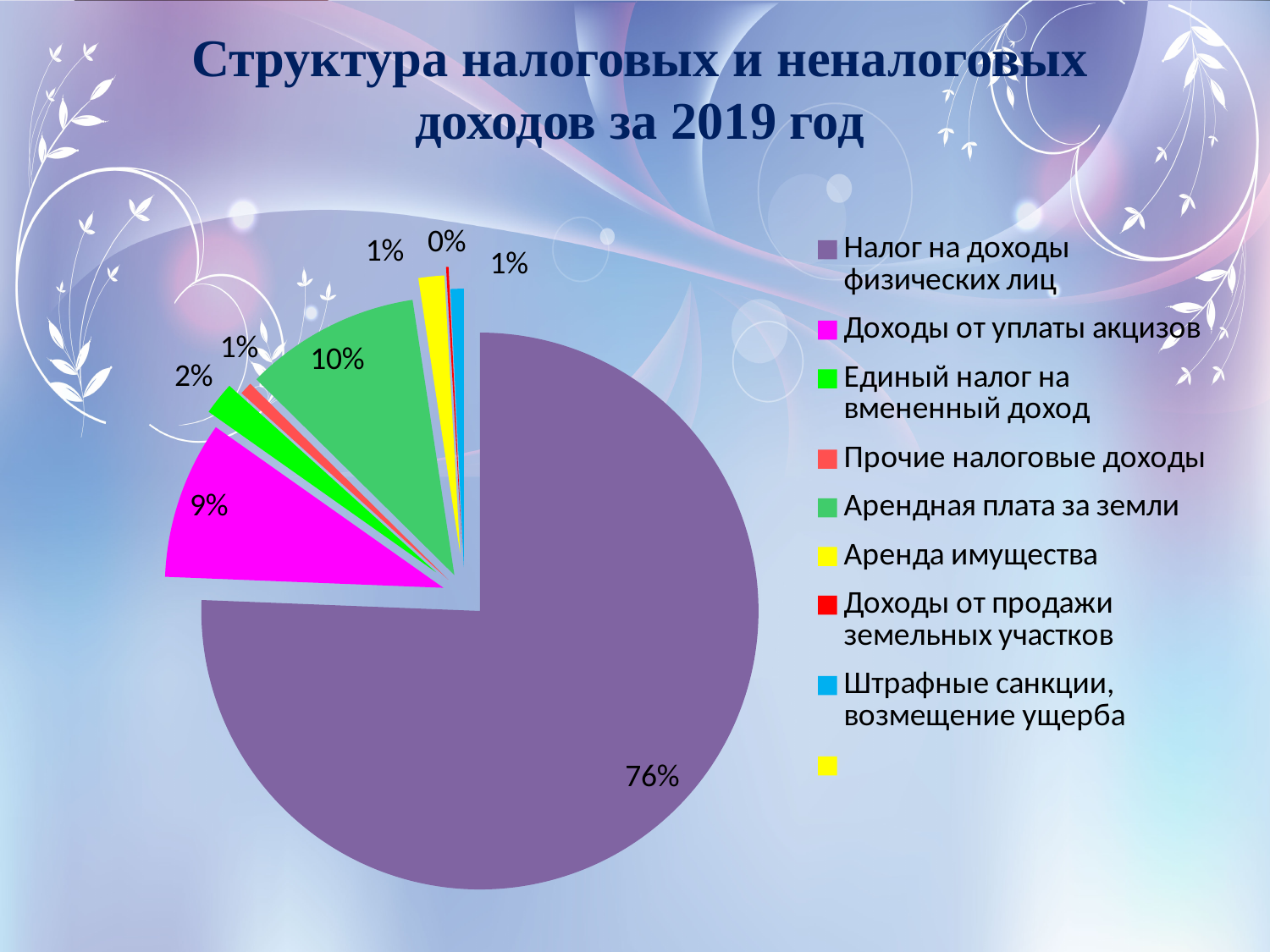
What share of the pie is Налог на доходы физических лиц? 76% Which is larger: Арендная плата за земли or Доходы от уплаты акцизов? Арендная плата за земли Which category has the smallest slice of the pie? Доходы от продажи земельных участков What is the title of the chart? Структура налоговых и неналоговых доходов за 2019 год What share of the pie is Доходы от уплаты акцизов? 9% Which category has the largest slice of the pie? Налог на доходы физических лиц What share of the pie is Доходы от продажи земельных участков? 0% What kind of chart is shown on the slide? pie chart What is the difference between the shares of Налог на доходы физических лиц and Арендная плата за земли? 66% What colour is the slice for Налог на доходы физических лиц? purple